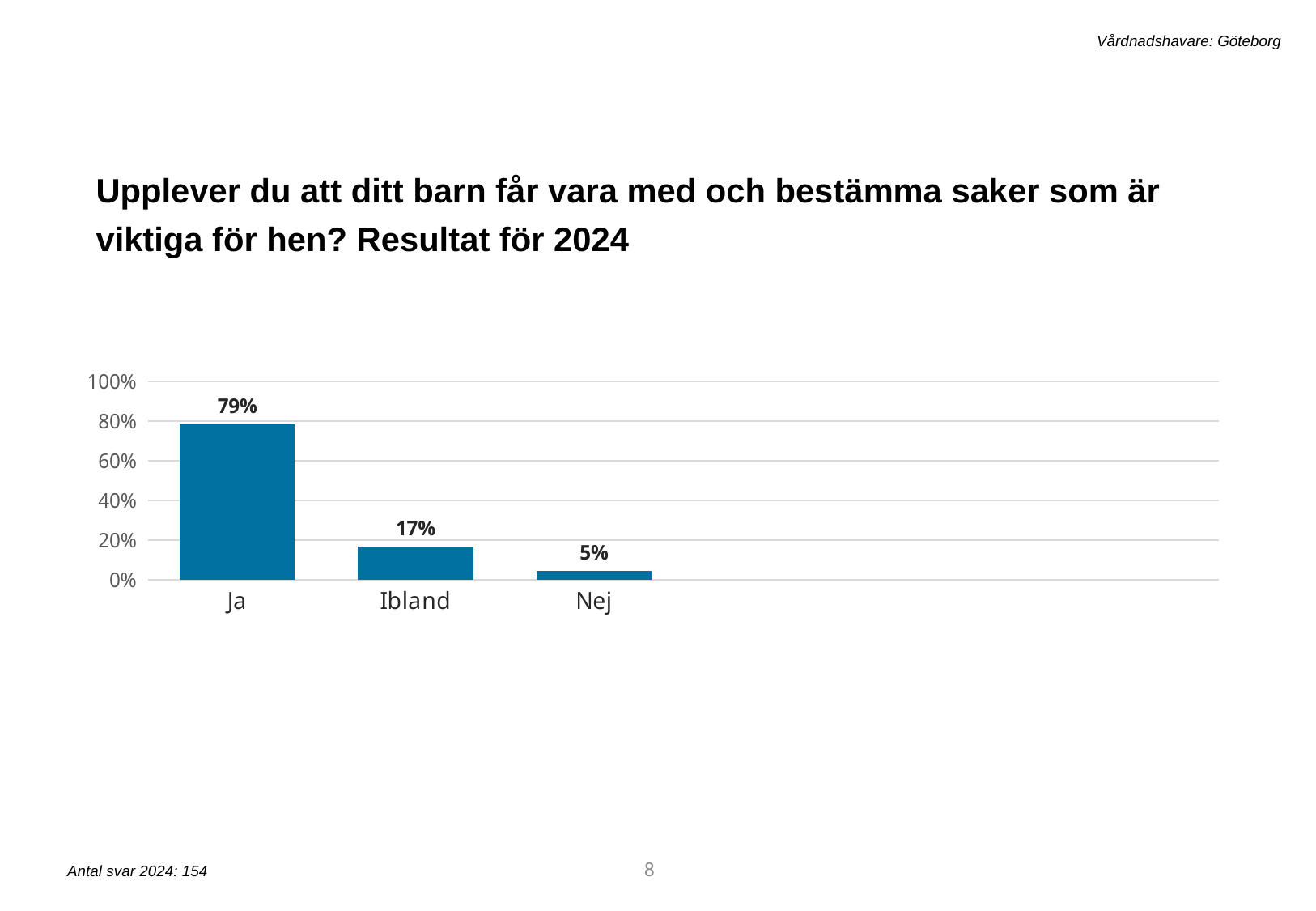
Which category has the lowest value? Nej What is the difference between the values for Ja and Ibland? 62% Is the value for Ja greater or less than 60%? greater What is the value for Nej? 5% Do the values rise or fall from left to right along the x axis? fall What is the value for Ibland? 17% What is the value for Ja? 79% What kind of chart is shown on the slide? bar chart Which category has the highest value? Ja How many categories are shown on the x axis? 3 What is the difference between the values for Ibland and Nej? 12% Which is larger, the value for Ibland or the value for Nej? Ibland